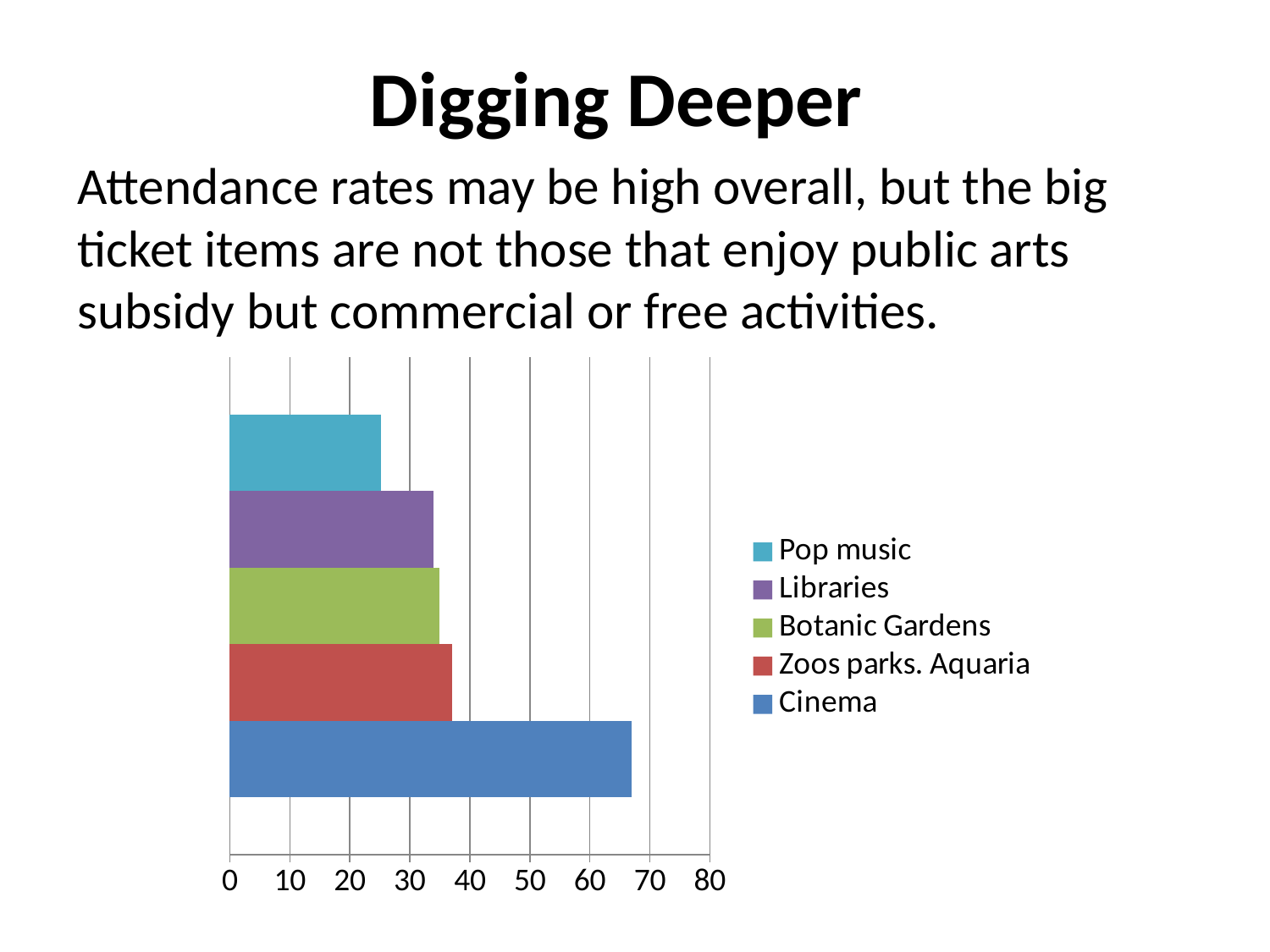
Is the value for Pop music greater or less than 30? less Which category has the highest value in the chart? Cinema How many entries does the chart's legend list? 5 What is the highest value shown on the chart's horizontal axis? 80 Is the value for Cinema greater or less than 60? greater What kind of chart is shown on the slide? bar chart Which is larger, the value for Cinema or the value for Pop music? Cinema Which category has the lowest value in the chart? Pop music Is the value for Zoos parks. Aquaria greater or less than 40? less Which legend entry is shown in blue? Cinema Which is larger, the value for Zoos parks. Aquaria or the value for Pop music? Zoos parks. Aquaria